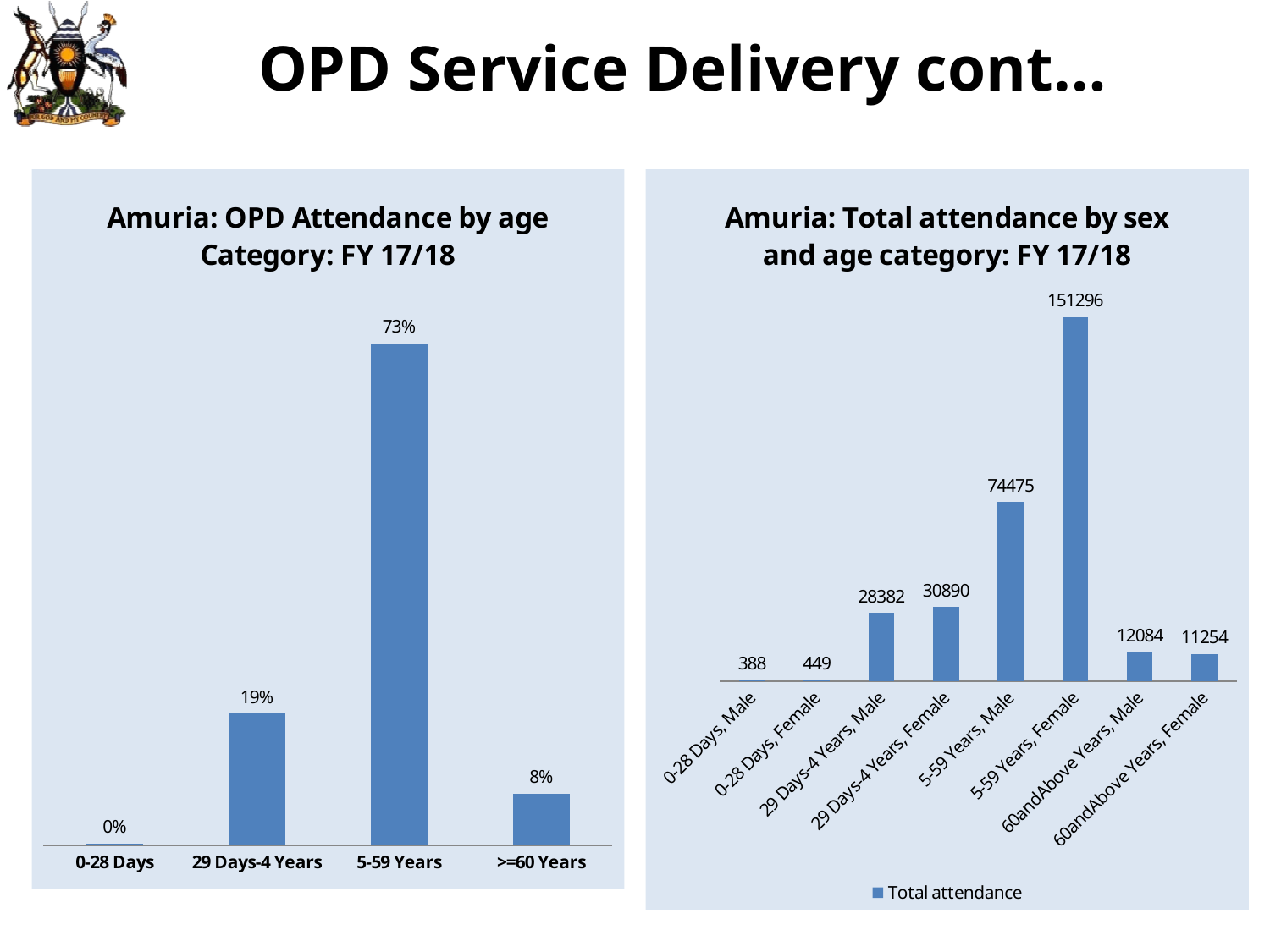
In the 'Amuria: Total attendance by sex and age category: FY 17/18' chart, what is the difference between 5-59 Years, Female and 5-59 Years, Male? 76821 What kind of chart is 'Amuria: OPD Attendance by age Category: FY 17/18'? Bar chart In the 'Amuria: Total attendance by sex and age category: FY 17/18' chart, which category has the highest value? 5-59 Years, Female In the 'Amuria: OPD Attendance by age Category: FY 17/18' chart, what is the value for 29 Days-4 Years? 19% In the 'Amuria: OPD Attendance by age Category: FY 17/18' chart, how many age categories are shown? 4 In the 'Amuria: Total attendance by sex and age category: FY 17/18' chart, which is larger: 60andAbove Years, Male or 60andAbove Years, Female? 60andAbove Years, Male In the 'Amuria: Total attendance by sex and age category: FY 17/18' chart, how many series does the legend list? 1 In the 'Amuria: OPD Attendance by age Category: FY 17/18' chart, what is the difference between the values for 5-59 Years and 29 Days-4 Years? 54% In the 'Amuria: Total attendance by sex and age category: FY 17/18' chart, what is the value for 29 Days-4 Years, Male? 28382 In the 'Amuria: OPD Attendance by age Category: FY 17/18' chart, which age category has the lowest value? 0-28 Days In the 'Amuria: Total attendance by sex and age category: FY 17/18' chart, what is the value for 5-59 Years, Female? 151296 In the 'Amuria: OPD Attendance by age Category: FY 17/18' chart, what is the value for 5-59 Years? 73%